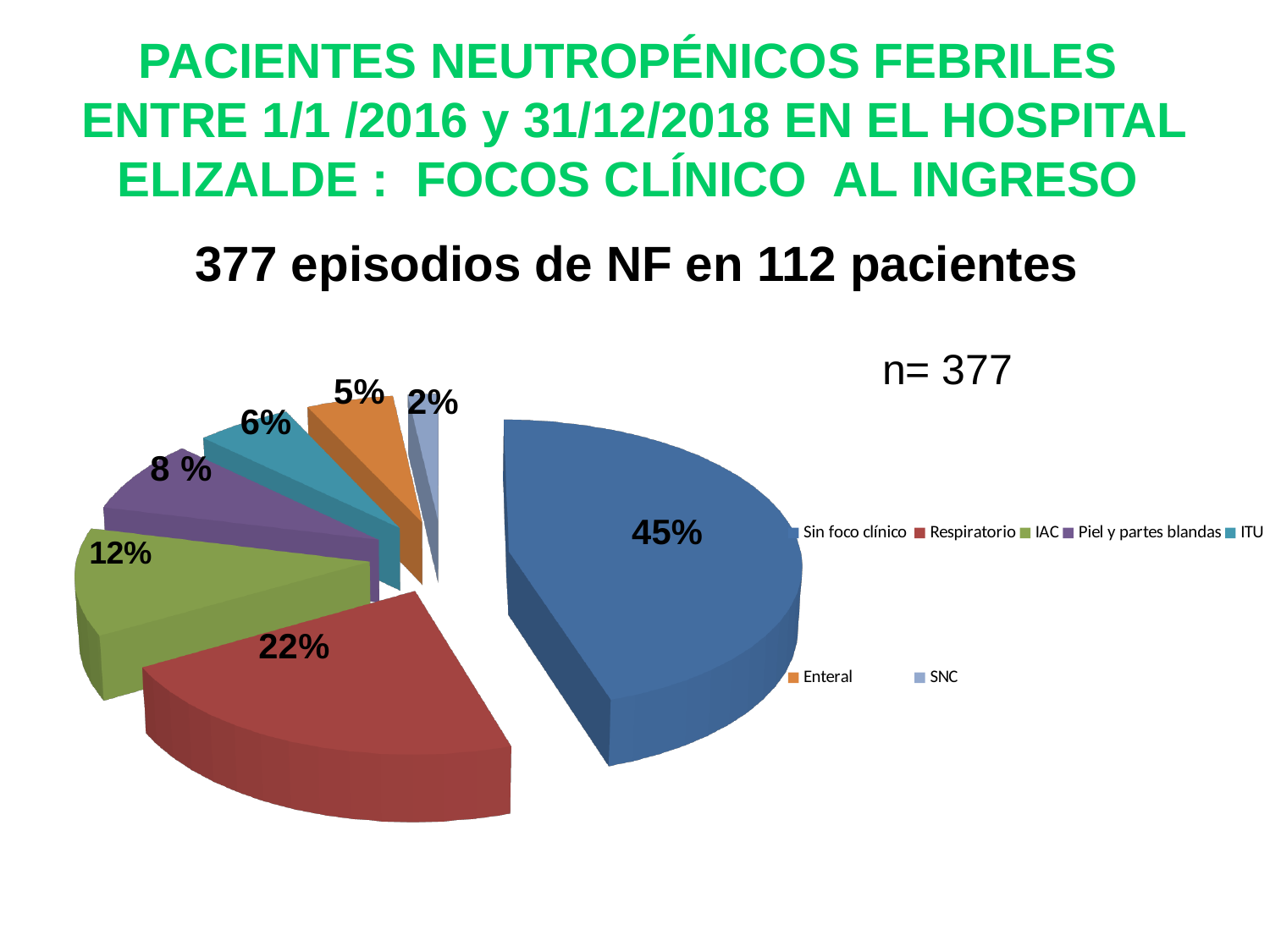
What share of the pie does the Respiratorio slice represent? 22% What share of the pie does the IAC slice represent? 12% What is the difference in percentage points between the Sin foco clínico slice and the Respiratorio slice? 23 What value of n is shown next to the pie chart? n= 377 What share of the pie does the ITU slice represent? 6% How many categories does the legend of the pie chart list? 7 Which slice is larger, Enteral or ITU? ITU What kind of chart is shown on the slide? pie chart Which category has the largest slice of the pie? Sin foco clínico Which category has the smallest slice of the pie? SNC